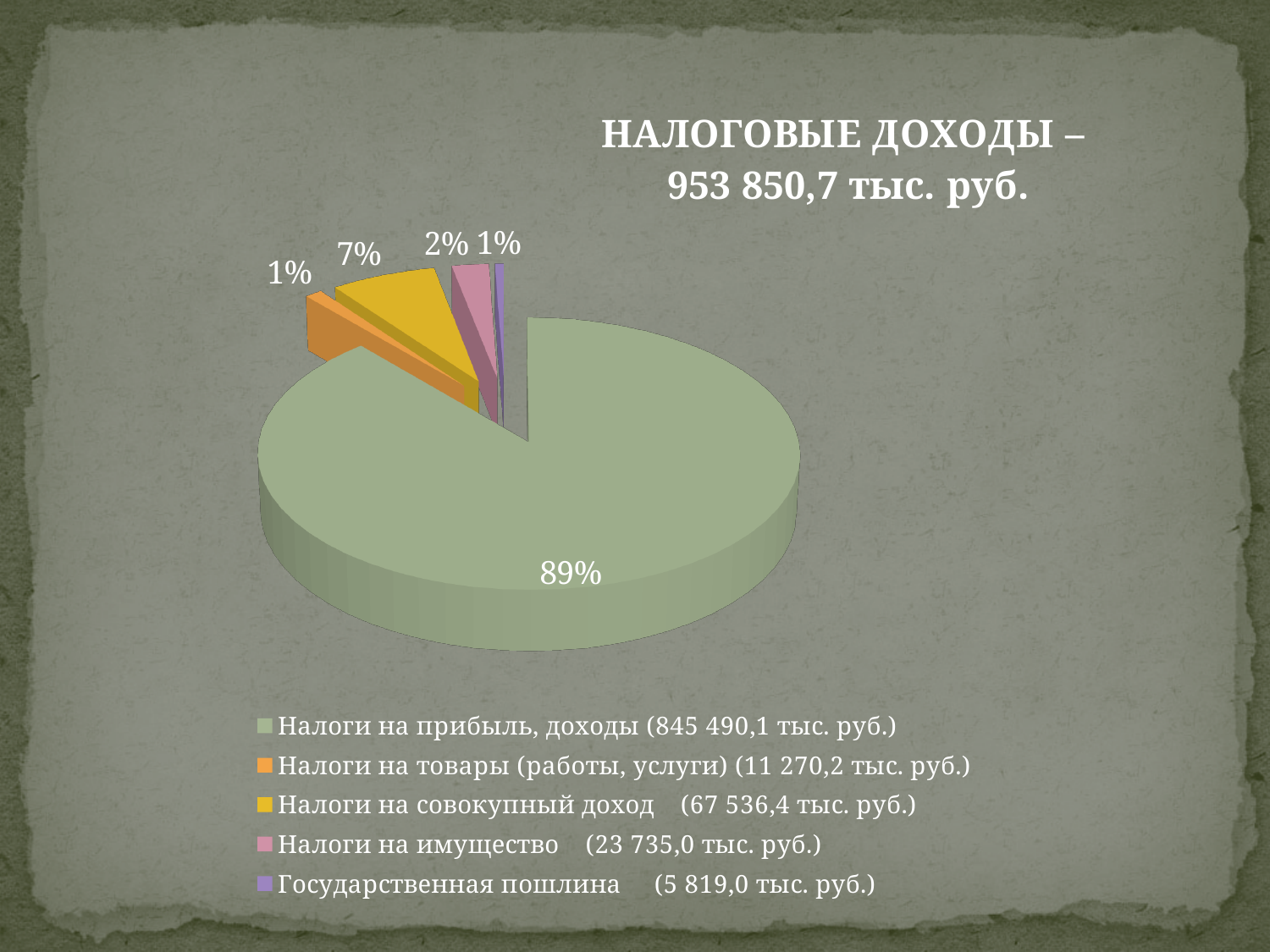
What amount is given in the legend for "Налоги на товары (работы, услуги)"? 11 270,2 тыс. руб. What share of the pie does "Налоги на совокупный доход" take? 7% Which is larger: the share for "Налоги на совокупный доход" or the share for "Налоги на имущество"? Налоги на совокупный доход Which category has the largest slice of the pie? Налоги на прибыль, доходы How many slices does the pie chart have? 5 What total amount of tax revenue is stated in the chart title? 953 850,7 тыс. руб. What kind of chart is shown on the slide? pie chart What share of the pie does "Налоги на прибыль, доходы" take? 89% What amount is given in the legend for "Государственная пошлина"? 5 819,0 тыс. руб. How many entries does the legend list? 5 What share of the pie does "Налоги на имущество" take? 2% By how many percentage points does the share of "Налоги на совокупный доход" exceed the share of "Налоги на имущество"? 5